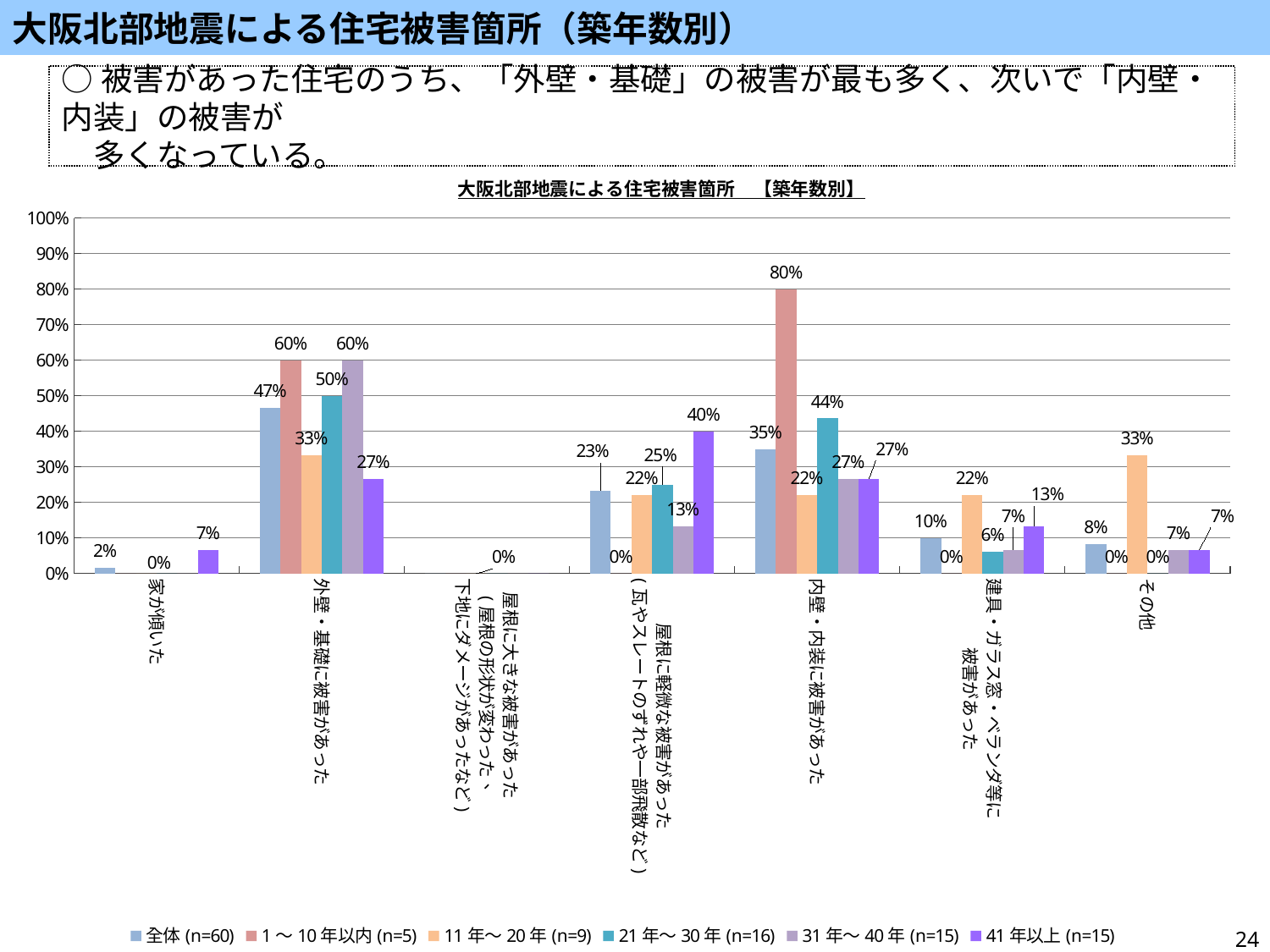
What is the value for 41年以上 in the 屋根に軽微な被害があった category? 40% Which series has the lowest value in the 外壁・基礎に被害があった category? 41年以上 (n=15) How many damage categories are shown along the x axis? 7 What is the sample size (n) shown in the legend for the 全体 series? n=60 What is the value for 全体 in the 外壁・基礎に被害があった category? 47% How many series does the legend list? 6 What kind of chart is shown on the slide? bar chart What is the value for 11年～20年 in the その他 category? 33% What is the value for 1～10年以内 in the 内壁・内装に被害があった category? 80% For the 全体 series, which is larger: 外壁・基礎に被害があった or 内壁・内装に被害があった? 外壁・基礎に被害があった What is the difference between the 1～10年以内 value and the 全体 value in the 内壁・内装に被害があった category? 45% Which series has the highest value in the 内壁・内装に被害があった category? 1～10年以内 (n=5)